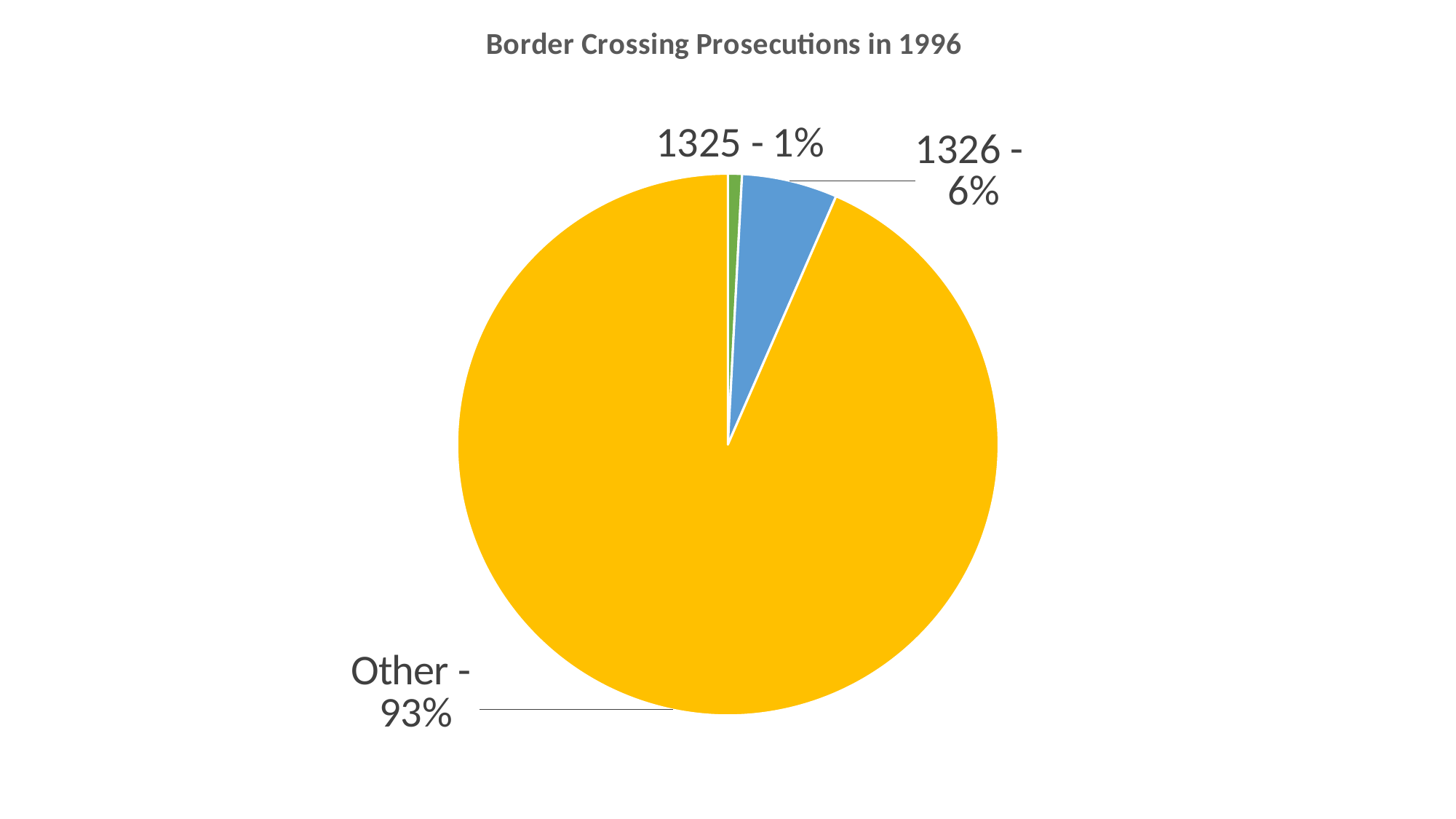
What colour is the 'Other' slice? yellow Which slice is the smallest? 1325 Which slice is the largest? Other Which slice is larger, '1326' or '1325'? 1326 What share of the pie does the 'Other' slice represent? 93% What kind of chart is shown on the slide? pie chart How many slices does the pie chart have? 3 What share of the pie does the '1325' slice represent? 1% What is the difference in percentage points between the '1326' slice and the '1325' slice? 5 What is the title of the chart? Border Crossing Prosecutions in 1996 What is the difference in percentage points between the 'Other' slice and the '1326' slice? 87 What share of the pie does the '1326' slice represent? 6%